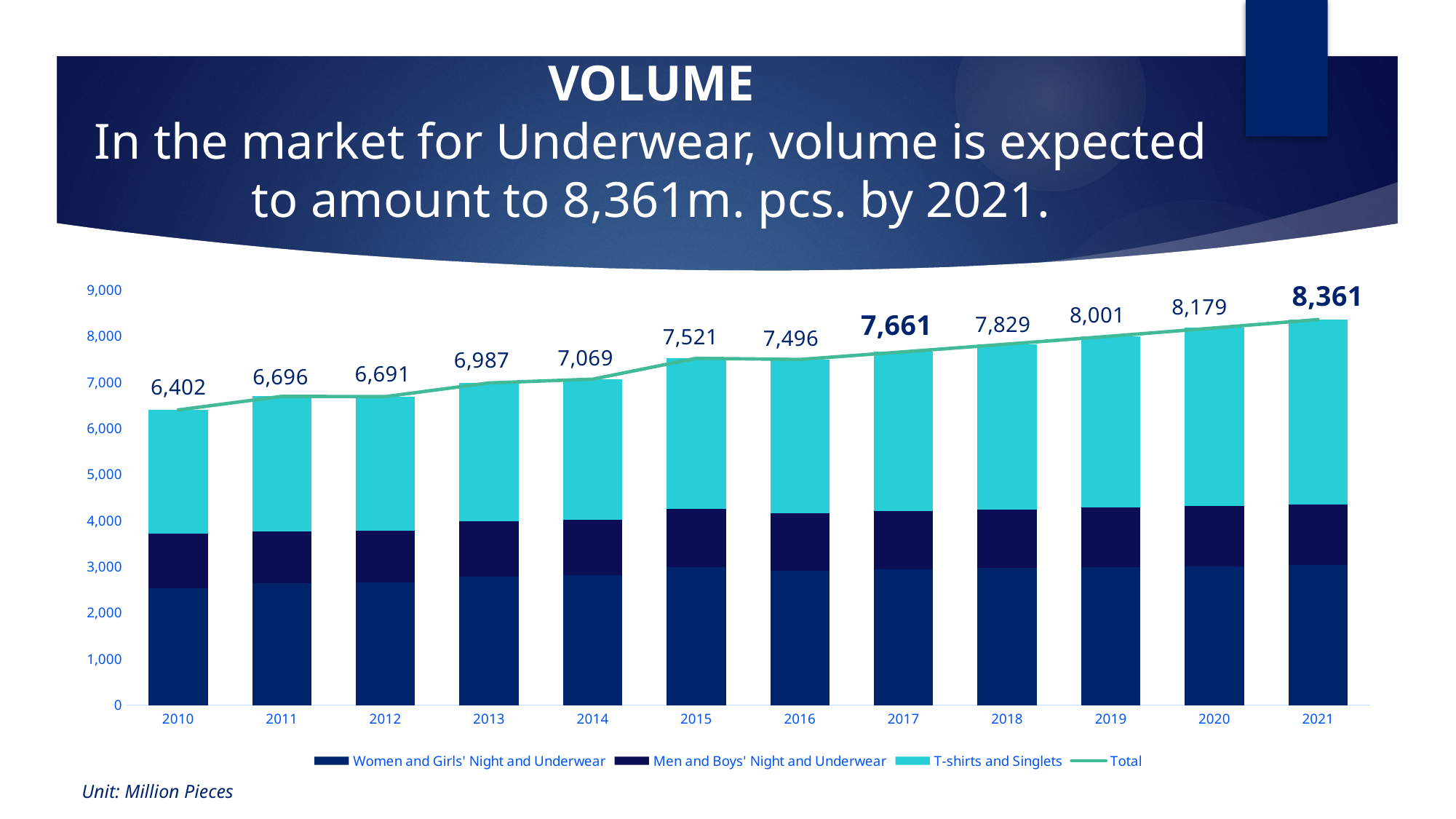
How many years are shown on the x axis? 12 Which year has the larger total volume, 2015 or 2016? 2015 Which year has the highest total volume? 2021 Is the value for Women and Girls' Night and Underwear in 2021 greater or less than 2,000? greater What is the total volume shown for 2021? 8,361 What is the difference between the total volume in 2021 and in 2010? 1,959 Which year has the lowest total volume? 2010 How many series does the legend list? 4 What is the total volume shown for 2017? 7,661 What is the total volume shown for 2010? 6,402 What unit is stated for the values in the chart? Million Pieces What kind of chart is shown on the slide? Stacked bar chart with a line